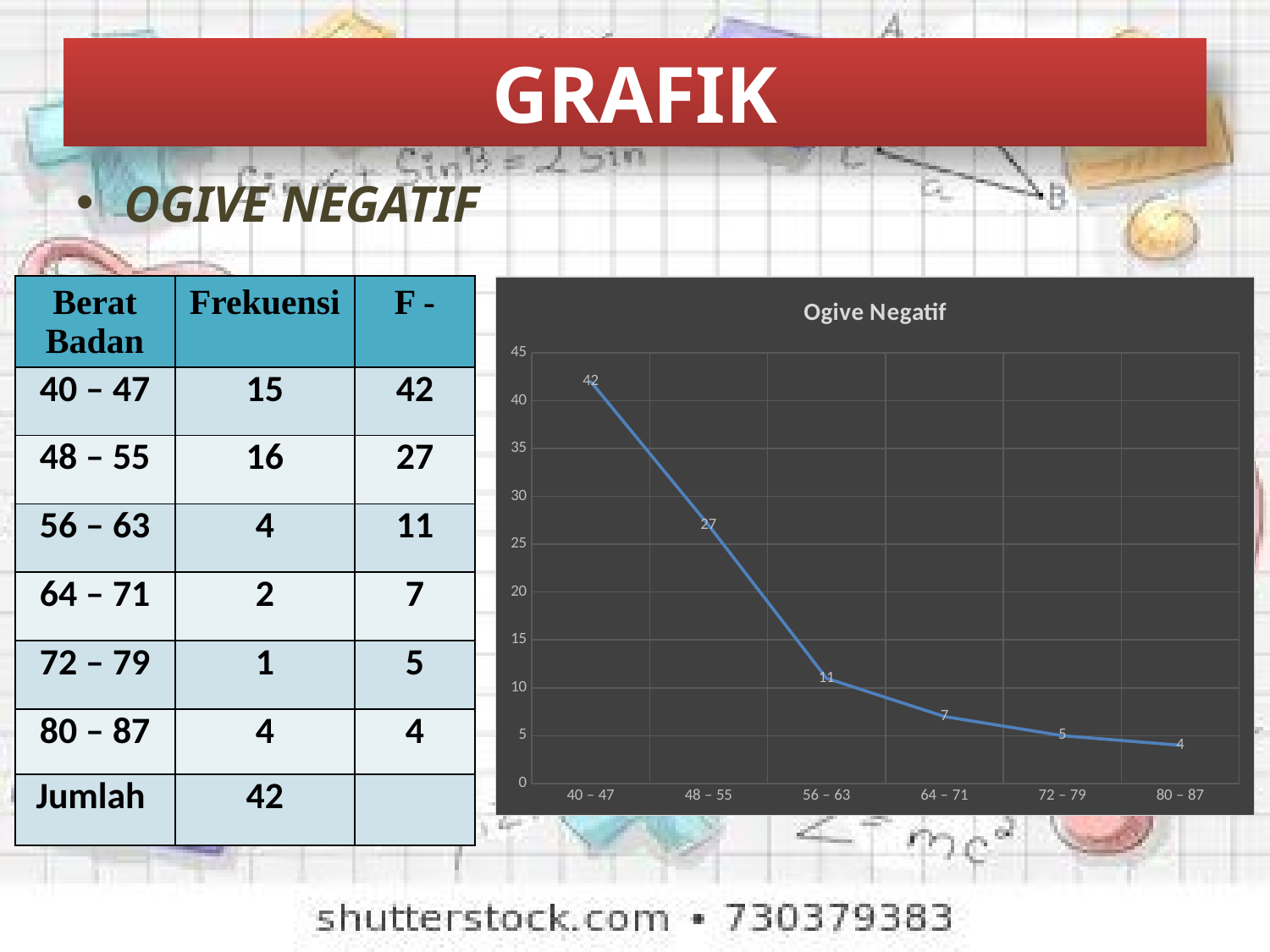
What kind of chart is the Ogive Negatif chart? line chart What is the value for the 56 – 63 category in the Ogive Negatif chart? 11 What is the value for the 40 – 47 category in the Ogive Negatif chart? 42 What is the difference between the values for 40 – 47 and 48 – 55 in the Ogive Negatif chart? 15 How many categories are plotted on the x axis of the Ogive Negatif chart? 6 Is the value for 48 – 55 in the Ogive Negatif chart greater or less than 25? greater What is the difference between the values for 56 – 63 and 64 – 71 in the Ogive Negatif chart? 4 Which category has the lowest value in the Ogive Negatif chart? 80 – 87 What is the value for the 72 – 79 category in the Ogive Negatif chart? 5 Do the values in the Ogive Negatif chart rise or fall from left to right along the x axis? fall Which category has the highest value in the Ogive Negatif chart? 40 – 47 Which is larger in the Ogive Negatif chart, the value for 48 – 55 or the value for 64 – 71? 48 – 55